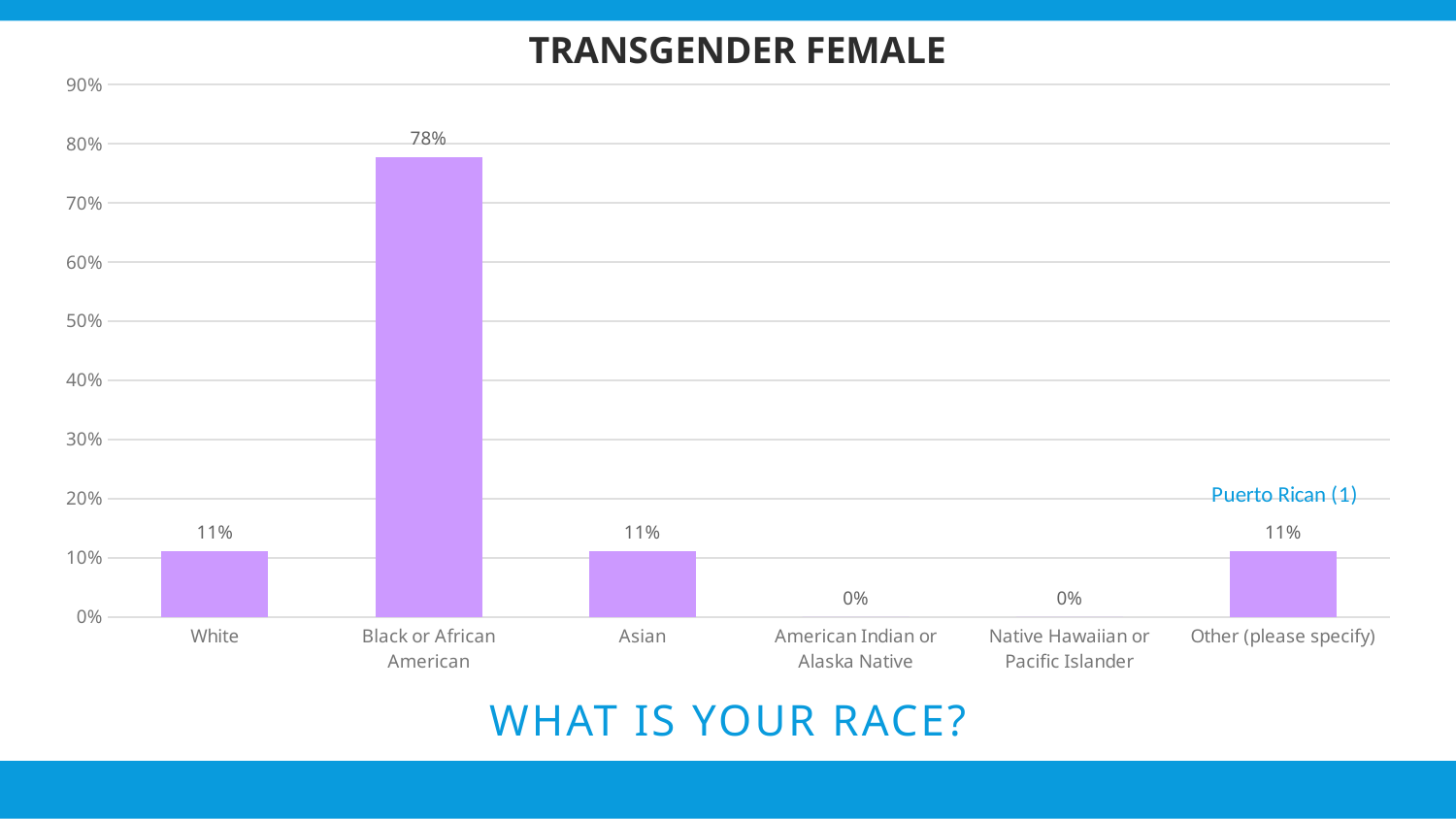
Is the value for Black or African American greater or less than 70%? greater What is the value for Black or African American? 78% What is the value for White? 11% What is the title of the chart? TRANSGENDER FEMALE How many categories are shown on the x axis? 6 What annotation is written above the Other (please specify) bar? Puerto Rican (1) Which is larger, the value for Black or African American or the value for White? Black or African American What kind of chart is shown on the slide? bar chart Which category has the highest value? Black or African American What is the value for American Indian or Alaska Native? 0% What is the difference between the values for Black or African American and Asian? 67% What is the value for Other (please specify)? 11%